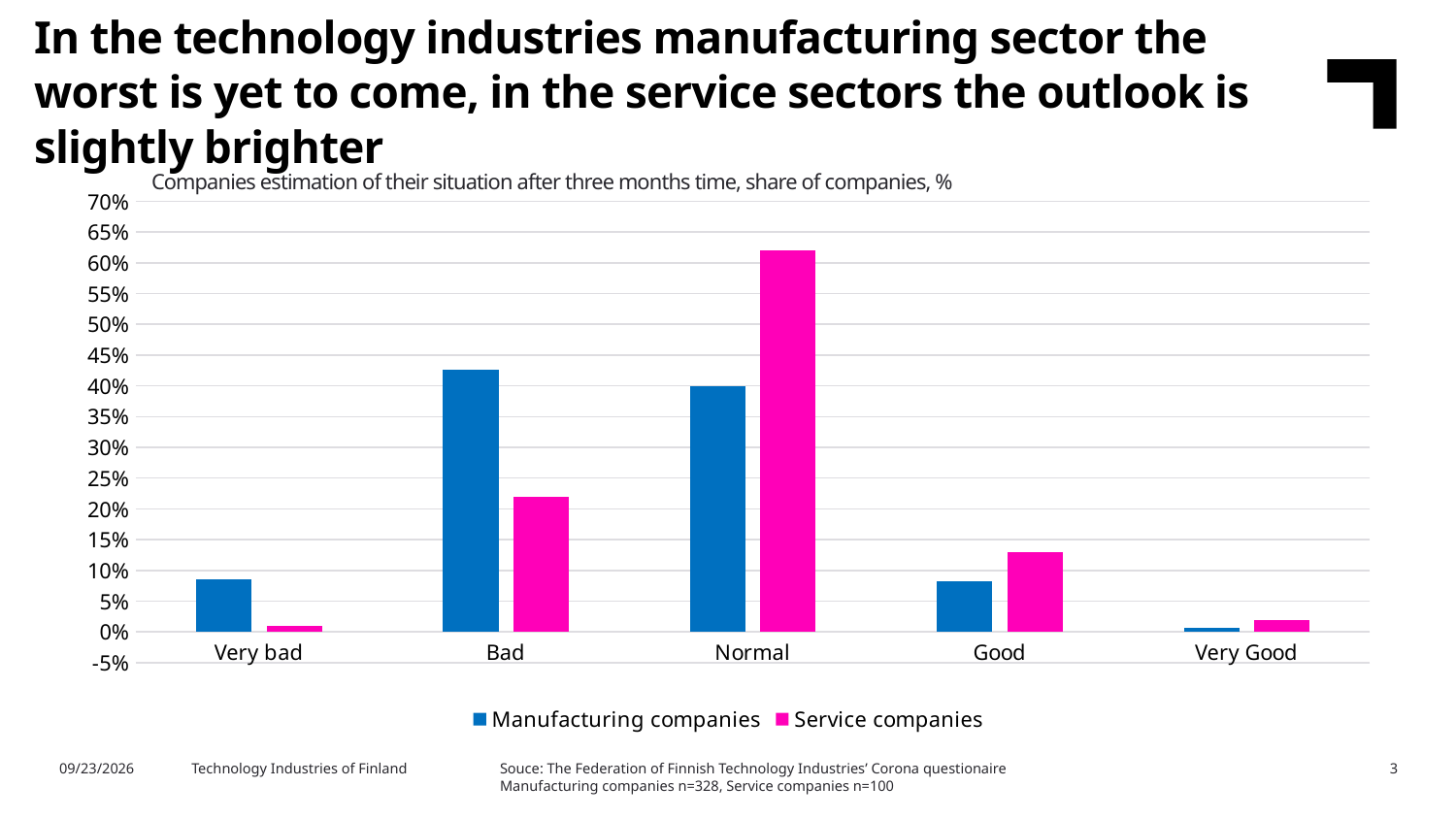
Which category has the highest value for Service companies? Normal Which category has the lowest value for Manufacturing companies? Very Good What kind of chart is shown on the slide? bar chart Which colour represents Service companies in the chart's legend? magenta (pink) Is the value for Service companies in the Bad category greater or less than 25%? less How many series does the chart's legend list? 2 Is the value for Manufacturing companies in the Normal category greater or less than 35%? greater For the Good category, which series has the larger value: Manufacturing companies or Service companies? Service companies For the Bad category, which series has the larger value: Manufacturing companies or Service companies? Manufacturing companies How many categories are shown on the x axis of the chart? 5 For the Normal category, which series has the larger value: Manufacturing companies or Service companies? Service companies Is the value for Service companies in the Normal category greater or less than 55%? greater